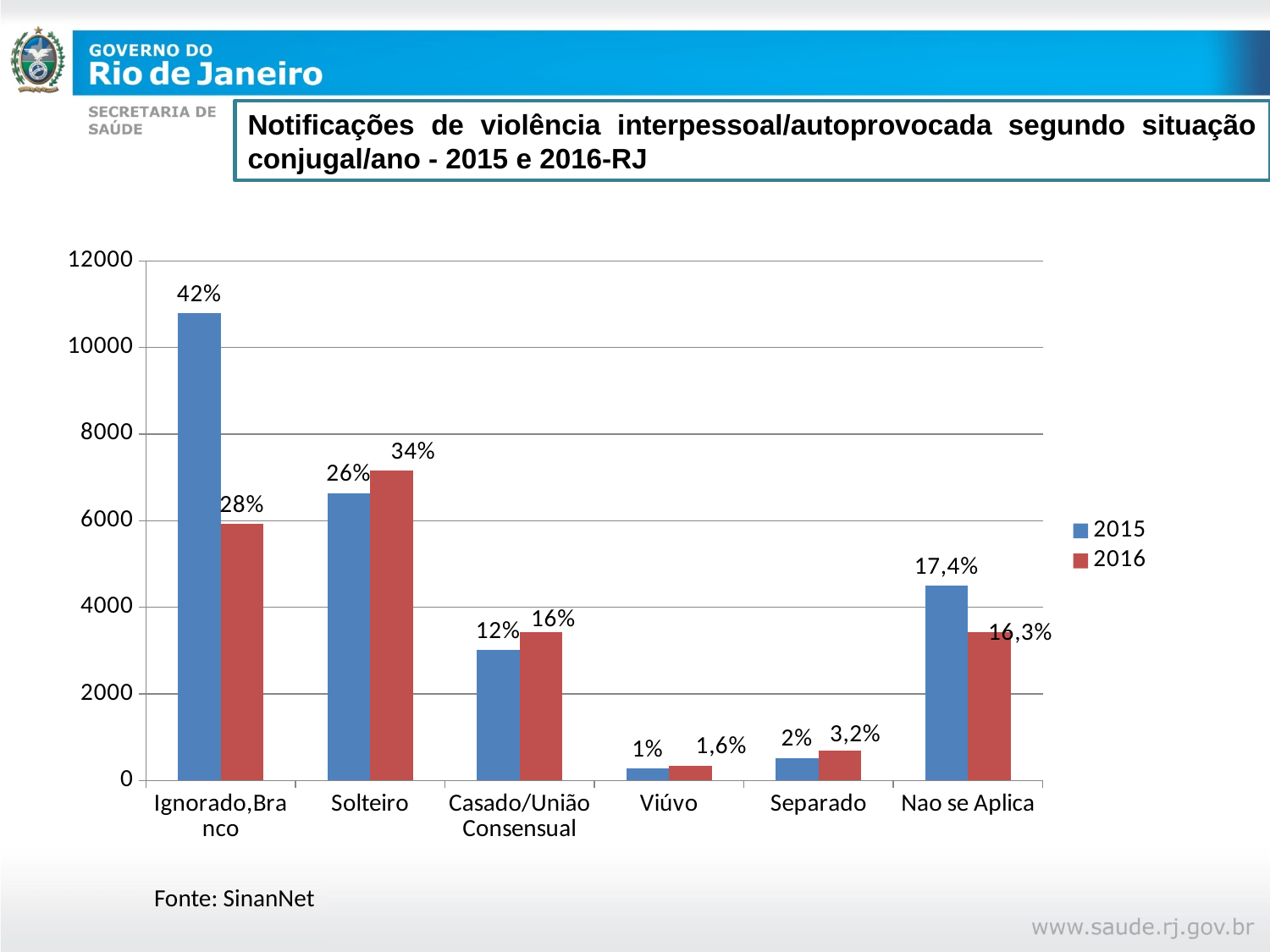
How many series does the legend list? 2 Which category has the shortest bar for 2015? Viúvo For Solteiro, which year has the taller bar, 2015 or 2016? 2016 How many categories are shown on the x axis? 6 What percentage label is shown on the 2015 bar for Ignorado,Branco? 42% Which category has the tallest bar for 2015? Ignorado,Branco What percentage label is shown on the 2016 bar for Solteiro? 34% What kind of chart is shown on the slide? bar chart What percentage label is shown on the 2016 bar for Nao se Aplica? 16,3% What percentage label is shown on the 2016 bar for Separado? 3,2% Which two years are listed in the legend? 2015 and 2016 Is the 2015 value for Ignorado,Branco greater or less than 10000? greater